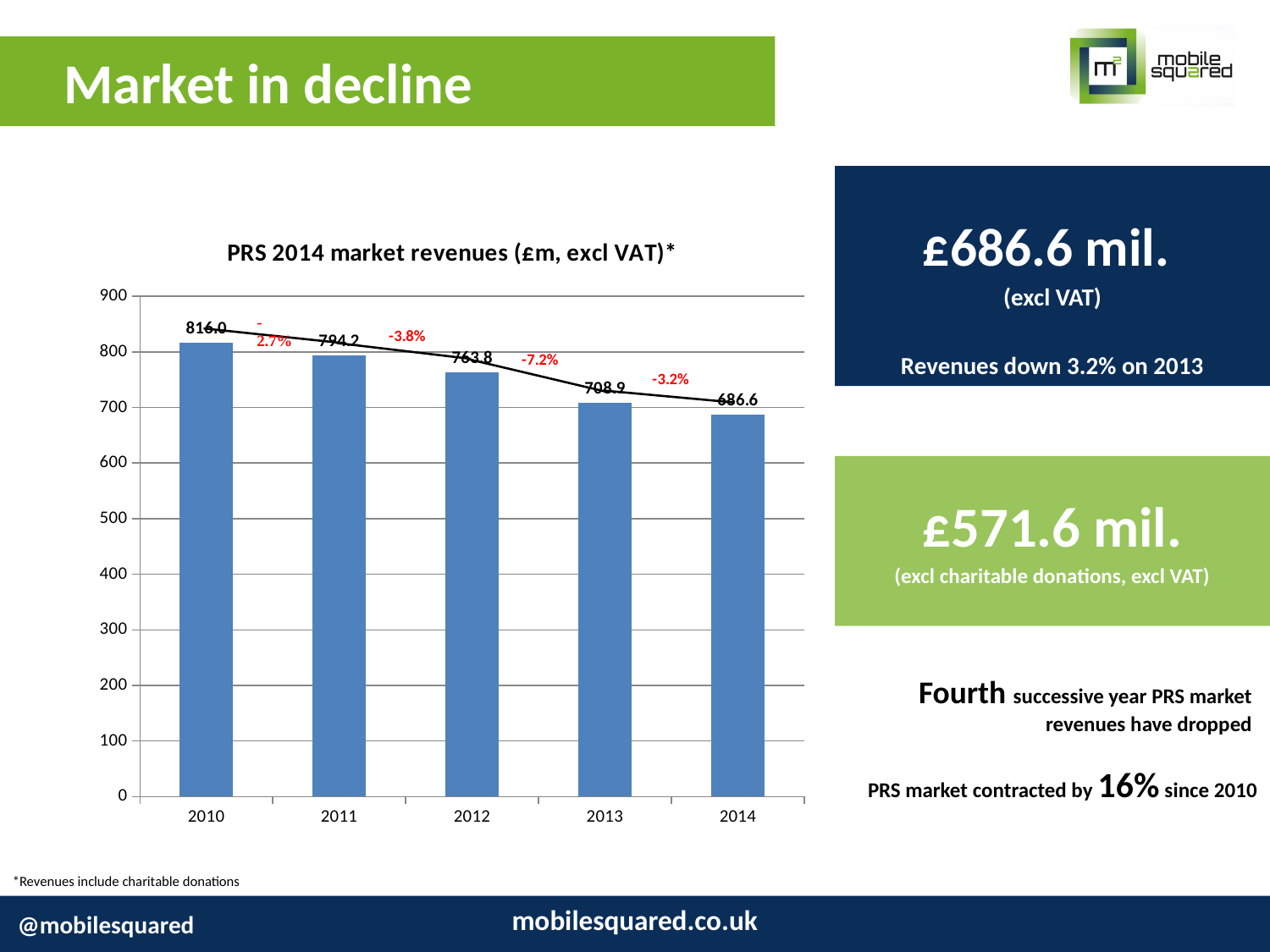
Is the value for 2013 greater or less than 800? less What is the difference between the values for 2012 and 2013? 54.9 Which year has the lowest value? 2014 Do the values rise or fall from 2010 to 2014? fall Which year has the highest value? 2010 What is the value for 2014? 686.6 Which is larger, the value for 2011 or the value for 2012? 2011 What is the value for 2013? 708.9 How many years are shown on the x axis? 5 What is the difference between the values for 2010 and 2014? 129.4 What is the value for 2010? 816.0 What kind of chart is this? bar chart